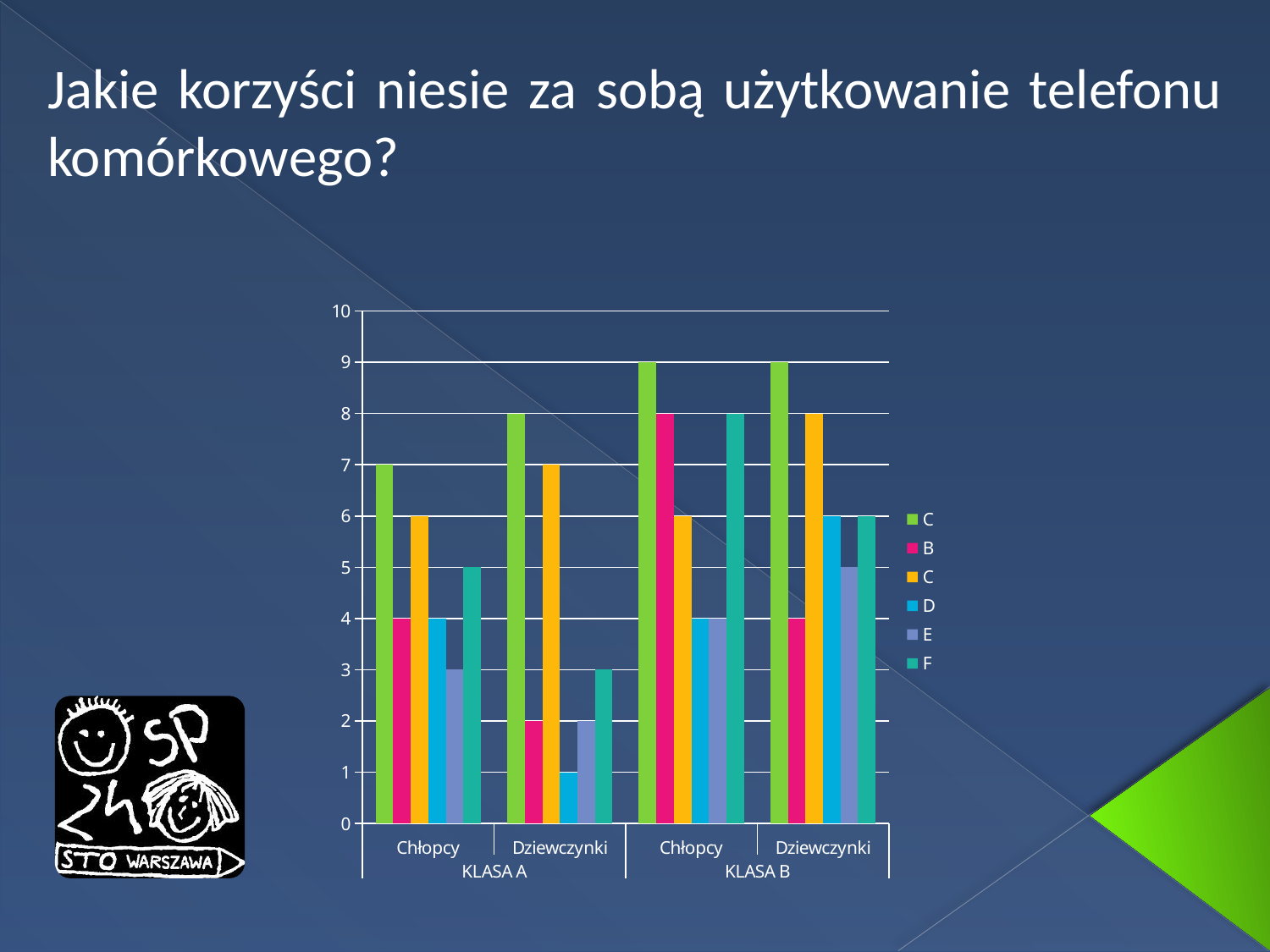
Which series has the lowest value for Dziewczynki in KLASA A? D How many category groups are shown along the x axis? 4 How many series does the legend list? 6 What type of chart is shown on the slide? bar chart What is the value of series F for Chłopcy in KLASA B? 8 What is the value of series D for Dziewczynki in KLASA A? 1 What is the value of series E for Dziewczynki in KLASA B? 5 What is the value of series B for Chłopcy in KLASA A? 4 Is the value of series E for Chłopcy in KLASA A greater or less than 5? less What is the highest value shown on the vertical axis? 10 Which is larger: series F for Chłopcy in KLASA A or series F for Dziewczynki in KLASA A? Chłopcy in KLASA A What is the difference between series B for Chłopcy in KLASA B and series B for Chłopcy in KLASA A? 4